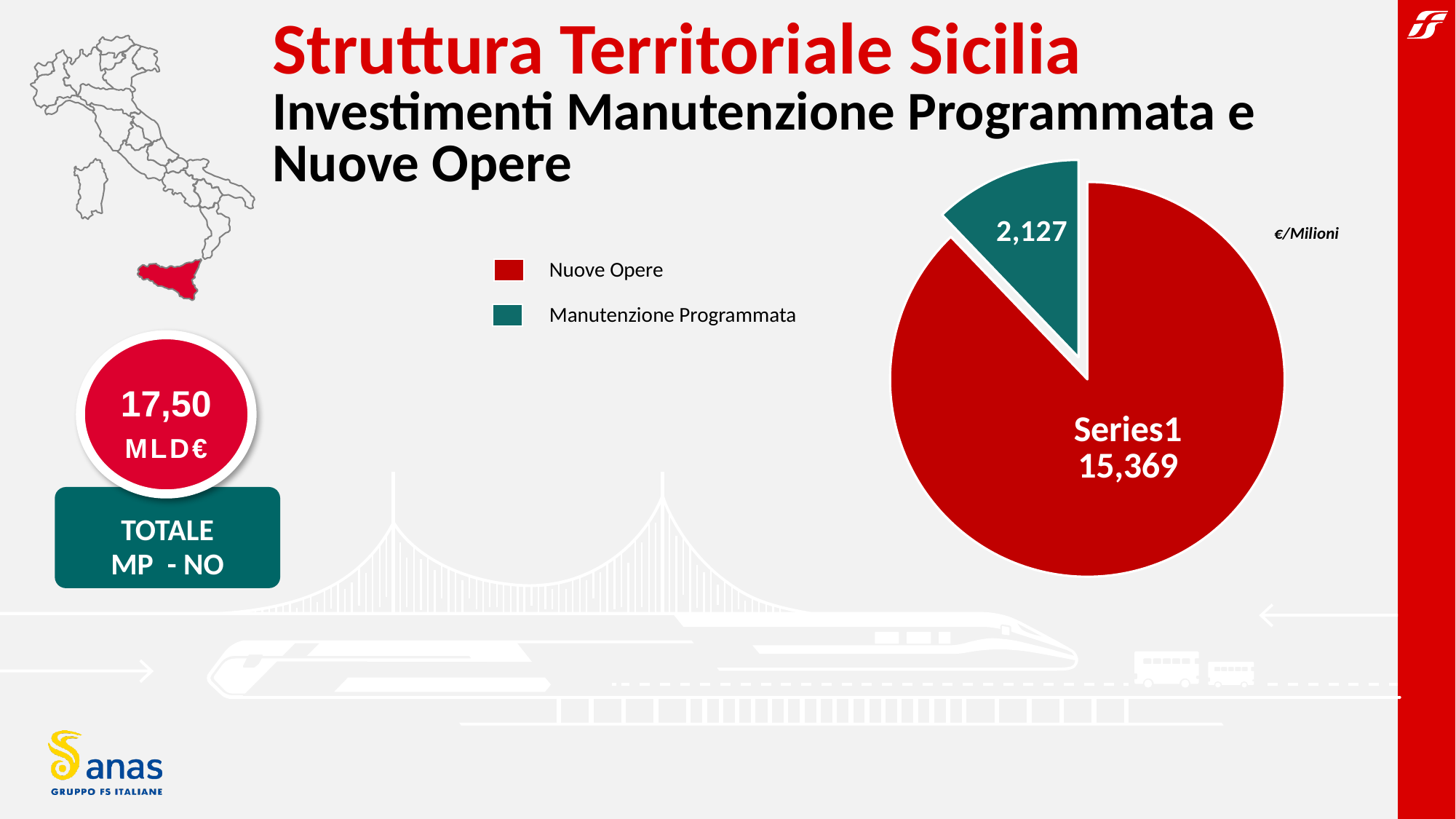
How many entries does the legend of the pie chart list? 2 What unit is indicated next to the pie chart? €/Milioni What is the total of the two slice values in the pie chart? 17,496 How many slices does the pie chart have? 2 What is the difference between the Nuove Opere value and the Manutenzione Programmata value in the pie chart? 13,242 Which is larger in the pie chart, Nuove Opere or Manutenzione Programmata? Nuove Opere What is the value of the Manutenzione Programmata slice in the pie chart? 2,127 What is the value of the Nuove Opere slice in the pie chart? 15,369 What colour is the Manutenzione Programmata slice in the pie chart? teal Which category has the smallest slice in the pie chart? Manutenzione Programmata Which category has the largest slice in the pie chart? Nuove Opere What type of chart is shown on the slide? pie chart